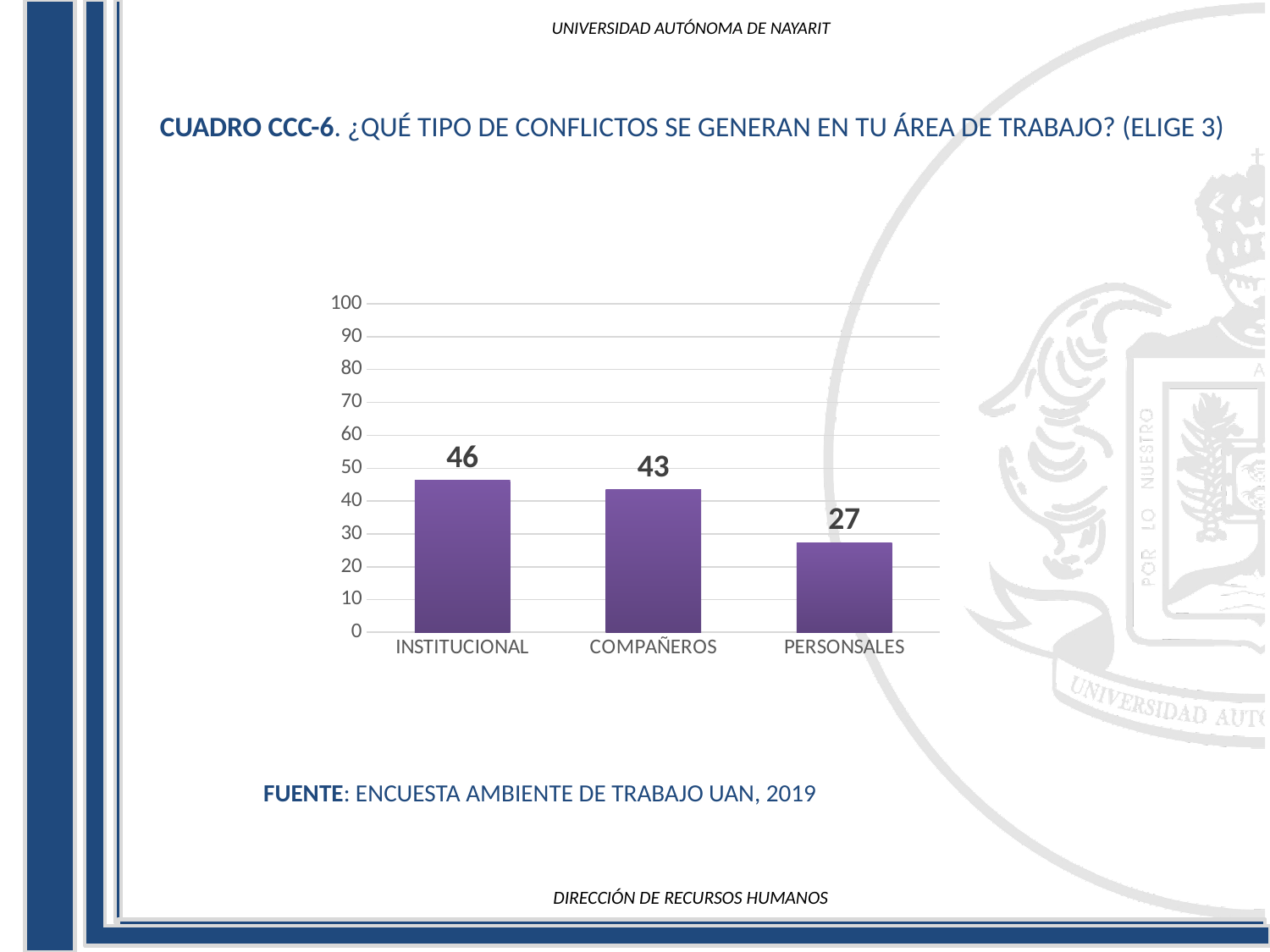
How many categories are shown on the x axis? 3 Which category has the highest value? INSTITUCIONAL What is the difference between the values for COMPAÑEROS and PERSONSALES? 16 Which is larger, the value for COMPAÑEROS or the value for PERSONSALES? COMPAÑEROS What is the value for PERSONSALES? 27 What is the value for INSTITUCIONAL? 46 Do the values rise or fall from left to right along the x axis? fall What is the difference between the values for INSTITUCIONAL and PERSONSALES? 19 Is the value for INSTITUCIONAL greater or less than 40? greater What is the value for COMPAÑEROS? 43 Which category has the lowest value? PERSONSALES What kind of chart is shown on the slide? bar chart